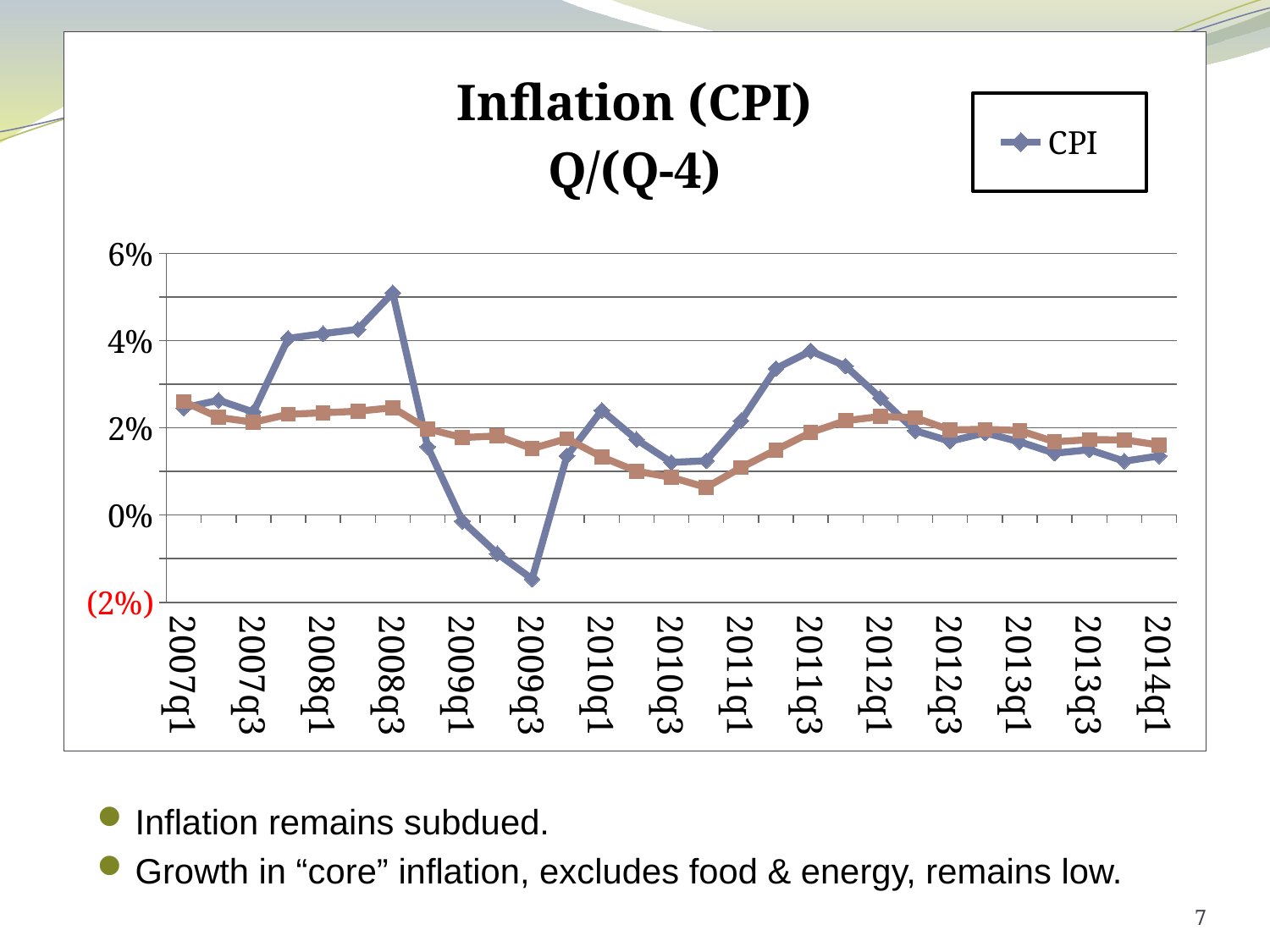
Which is larger, the CPI value at 2008q3 or at 2011q3? 2008q3 Is the CPI value at 2008q3 greater or less than 4%? greater At which quarter does the CPI line reach its highest value? 2008q3 What is the title of the chart? Inflation (CPI) Q/(Q-4) Is the CPI value at 2014q1 greater or less than 2%? less Is the CPI value at 2009q3 greater or less than 0%? less How many series does the legend list? 1 Does the CPI line rise or fall between 2008q3 and 2009q3? fall What kind of chart is shown on the slide? line chart Which series name appears in the legend? CPI At which quarter does the CPI line reach its lowest value? 2009q3